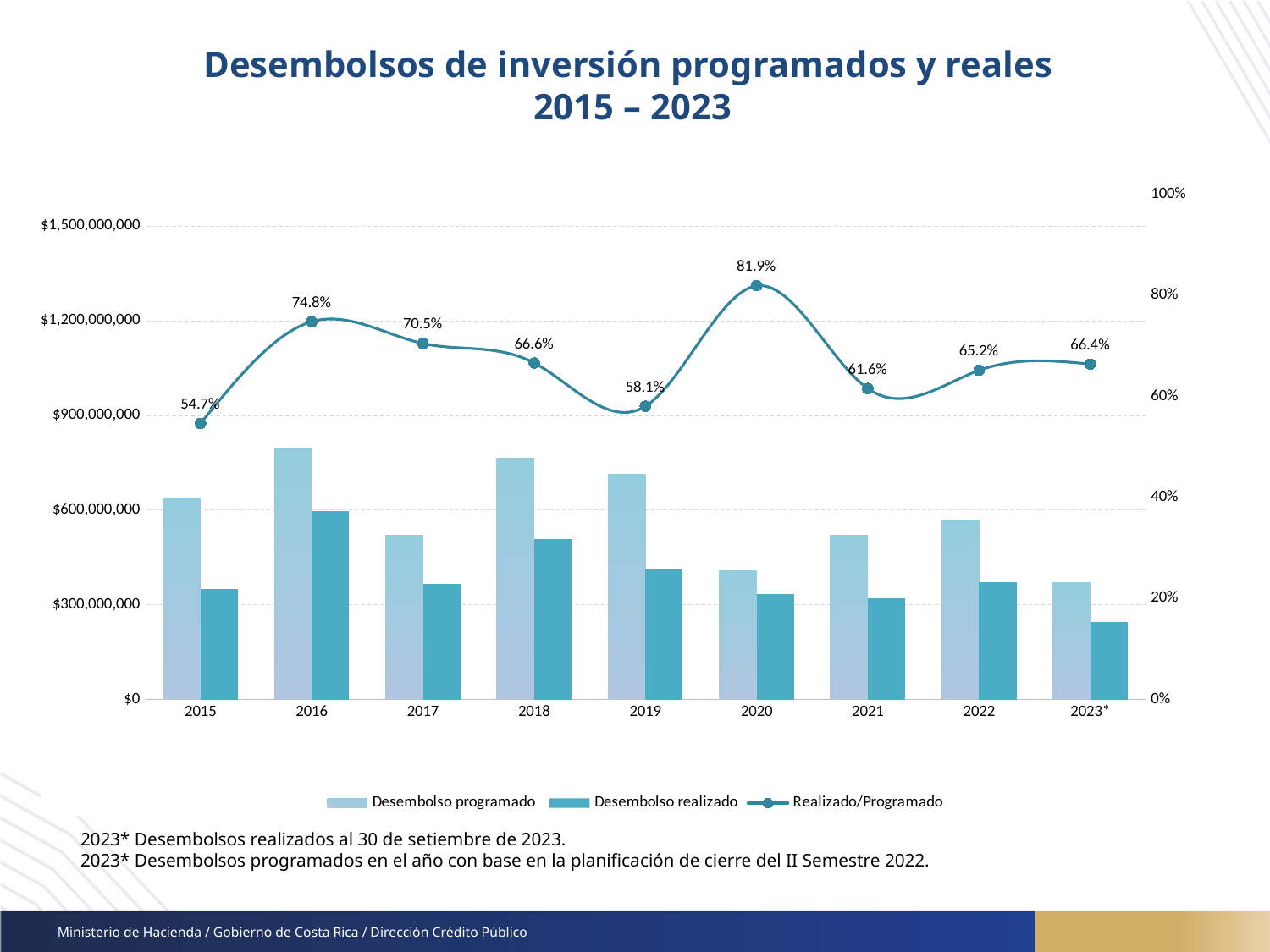
What kind of chart is shown on the slide? Combination bar and line chart What is the Realizado/Programado value for 2023*? 66.4% Is the Desembolso programado value for 2016 greater or less than $600,000,000? greater Is the Desembolso realizado value for 2023* greater or less than $300,000,000? less In which year is the Realizado/Programado ratio lowest? 2015 In which year is the Realizado/Programado ratio highest? 2020 How many years are shown on the x axis of the chart? 9 How many series does the legend list? 3 Which year has a higher Realizado/Programado value, 2016 or 2017? 2016 What is the difference in percentage points between the Realizado/Programado values for 2020 and 2015? 27.2 percentage points What is the Realizado/Programado value for 2015? 54.7% What is the Realizado/Programado value for 2020? 81.9%